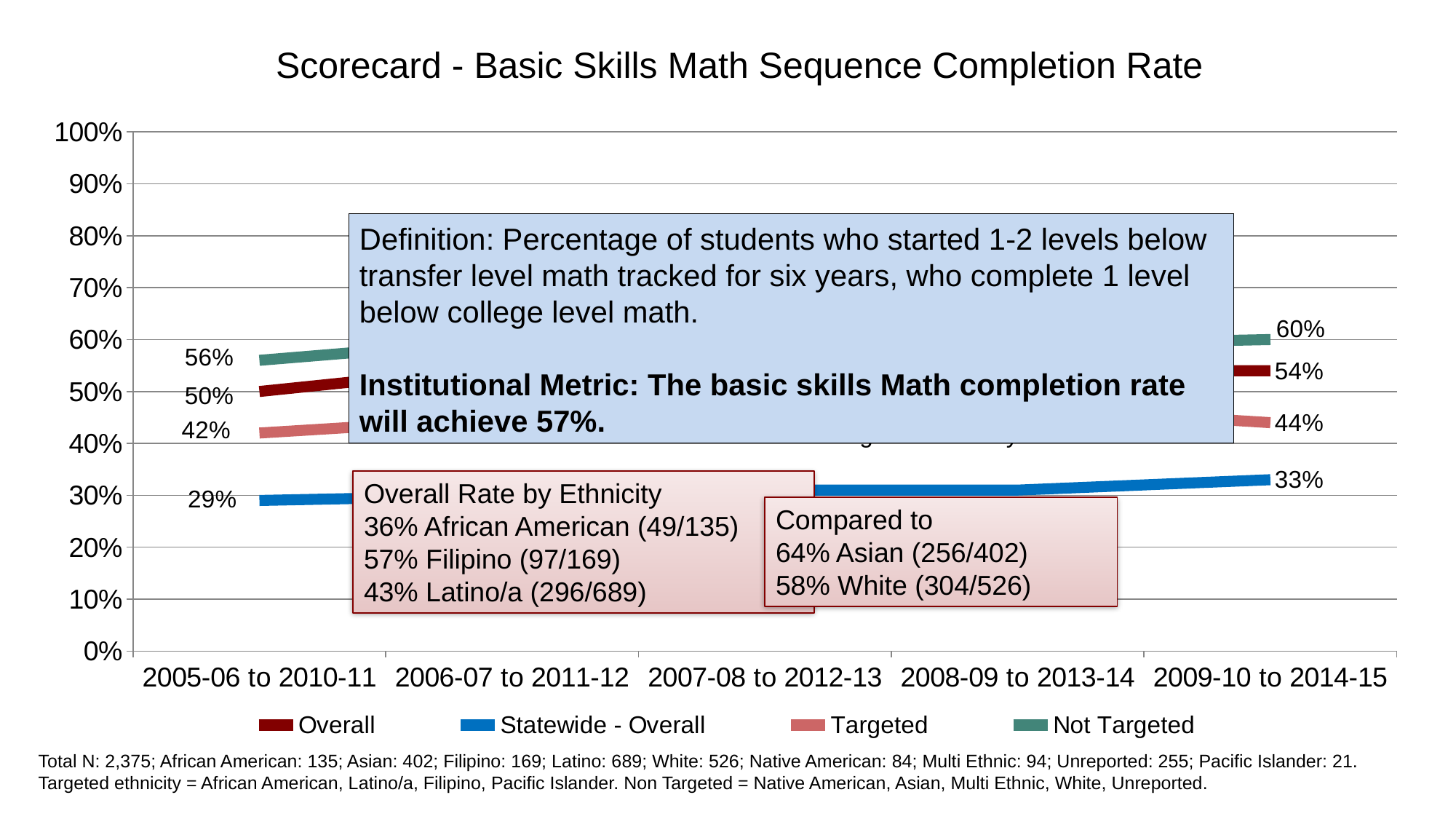
How many cohort periods are shown on the x axis? 5 What is the Statewide - Overall completion rate for 2009-10 to 2014-15? 33% What is the Not Targeted completion rate for 2005-06 to 2010-11? 56% Which series has the lowest value for 2005-06 to 2010-11? Statewide - Overall How many series does the legend list? 4 What is the Overall completion rate for 2009-10 to 2014-15? 54% Which series has the highest value for 2009-10 to 2014-15? Not Targeted What is the difference between the Not Targeted and Targeted rates for 2009-10 to 2014-15? 16% What is the Targeted completion rate for 2005-06 to 2010-11? 42% Is the Overall rate for 2005-06 to 2010-11 larger or smaller than the Targeted rate for the same period? larger Does the Overall completion rate rise or fall from 2005-06 to 2010-11 to 2009-10 to 2014-15? rise What type of chart is shown on the slide? line chart